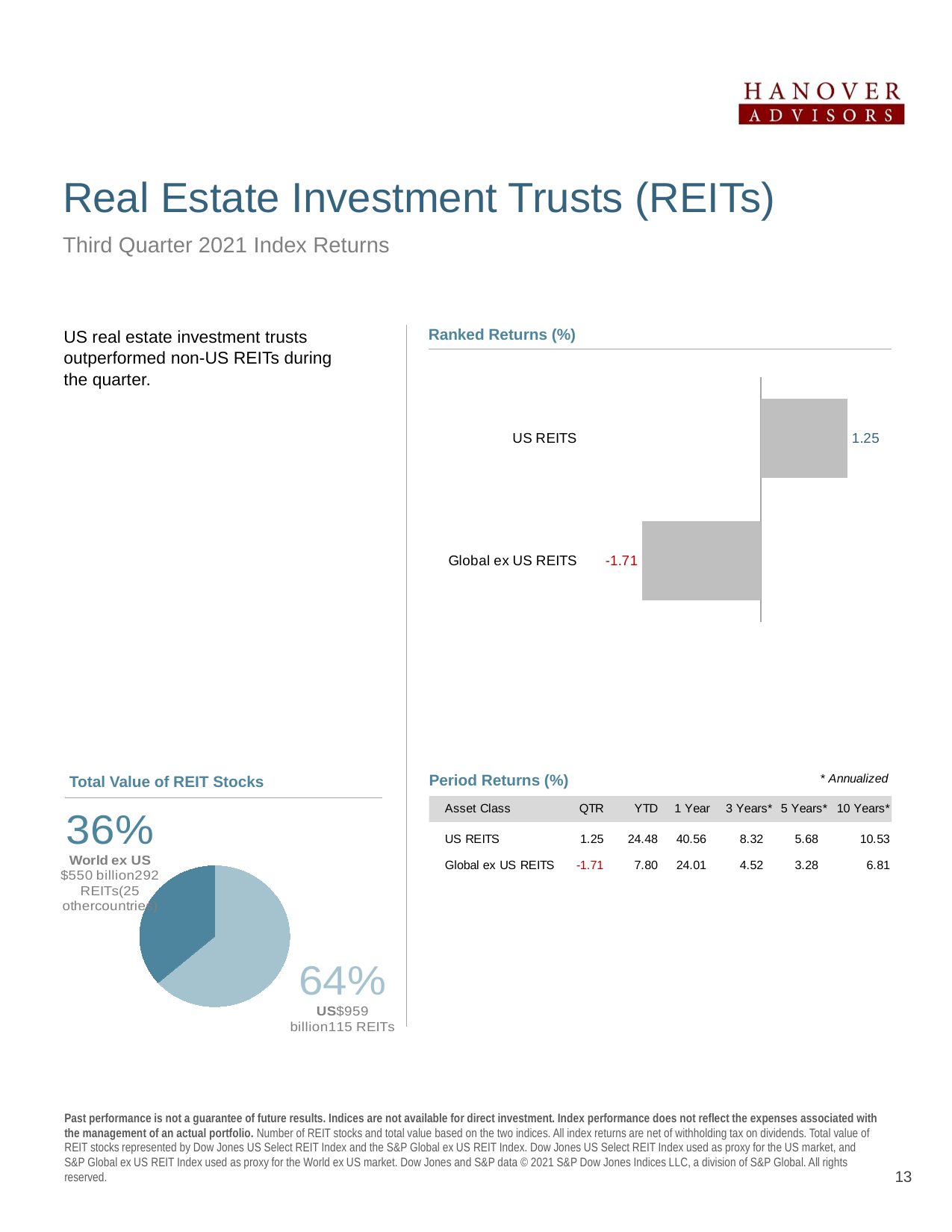
In the Total Value of REIT Stocks chart, what share of the pie is World ex US? 36% In the Ranked Returns (%) chart, which category has the lowest value? Global ex US REITS In the Total Value of REIT Stocks chart, what share of the pie is US? 64% In the Total Value of REIT Stocks chart, how many slices does the pie have? 2 What kind of chart is the Total Value of REIT Stocks chart? Pie chart In the Ranked Returns (%) chart, what is the value for Global ex US REITS? -1.71 In the Ranked Returns (%) chart, which category has the highest value? US REITS In the Total Value of REIT Stocks chart, which slice is larger, US or World ex US? US In the Ranked Returns (%) chart, what is the difference between the US REITS and Global ex US REITS values? 2.96 In the Ranked Returns (%) chart, how many categories are plotted? 2 What kind of chart is the Ranked Returns (%) chart? Bar chart In the Ranked Returns (%) chart, what is the value for US REITS? 1.25